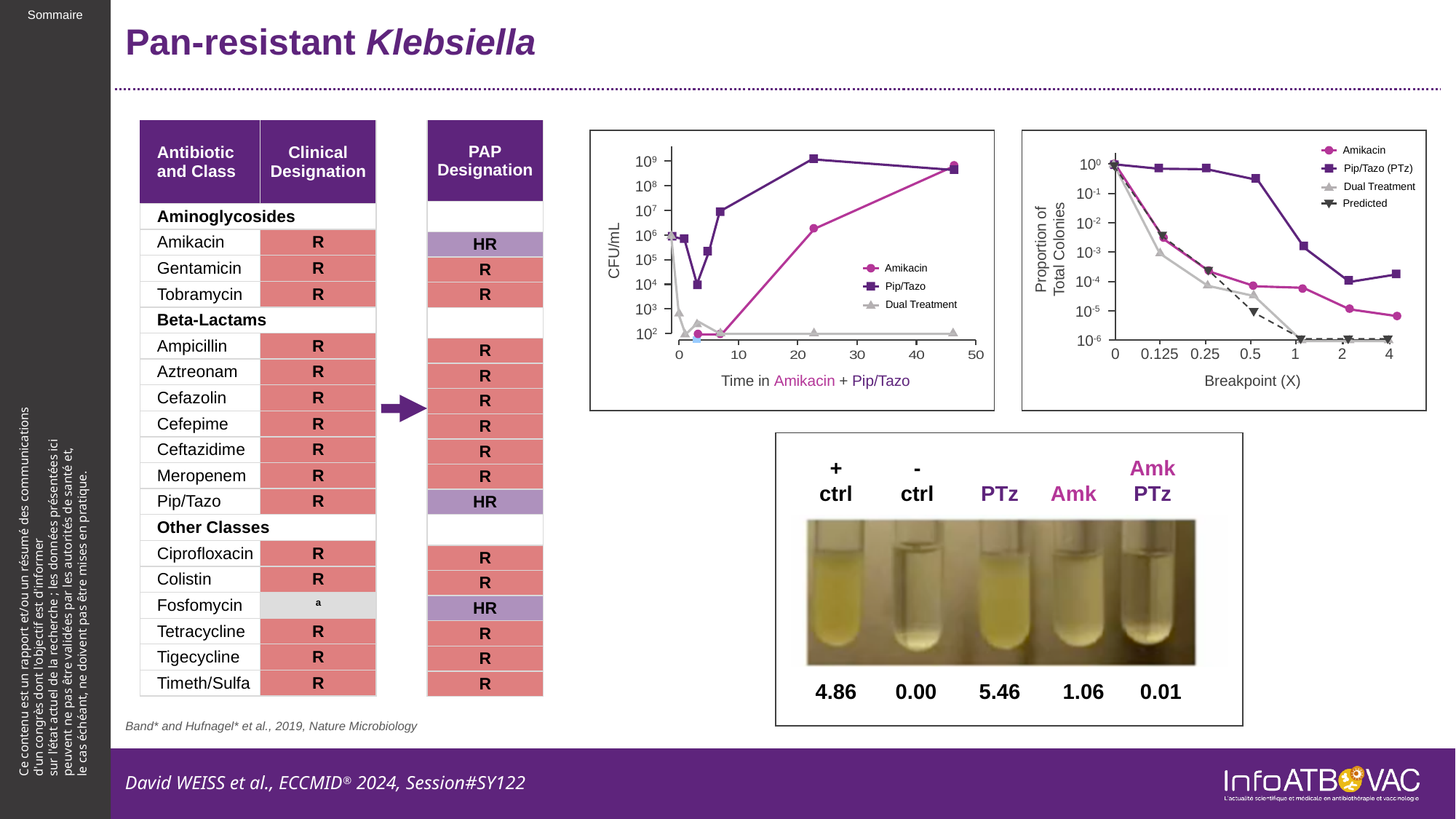
In the right chart (Proportion of Total Colonies), does the Pip/Tazo (PTz) series rise or fall as the breakpoint increases? fall In the left chart (CFU/mL vs time), which series stays lowest across the time course? Dual Treatment How many series does the legend of the right chart (Proportion of Total Colonies vs Breakpoint) list? 4 How many breakpoint tick values are labelled on the x axis of the right chart? 7 In the left chart (CFU/mL vs time), is the Dual Treatment value at the last time point greater or less than 10^3? less In the left chart (CFU/mL vs time), is the peak value of the Pip/Tazo series greater or less than 10^8? greater In the left chart (CFU/mL vs time), which series reaches the highest CFU/mL value? Pip/Tazo What is the x-axis label of the left chart (CFU/mL on the y axis)? Time in Amikacin + Pip/Tazo In the right chart (Proportion of Total Colonies), is the Pip/Tazo (PTz) value at breakpoint 2 greater or less than 10^-5? greater In the right chart (Proportion of Total Colonies), which series has the highest proportion at breakpoint 4? Pip/Tazo (PTz) How many series does the legend of the left chart (CFU/mL vs time) list? 3 What kind of chart is the left chart with CFU/mL on the y axis? line chart